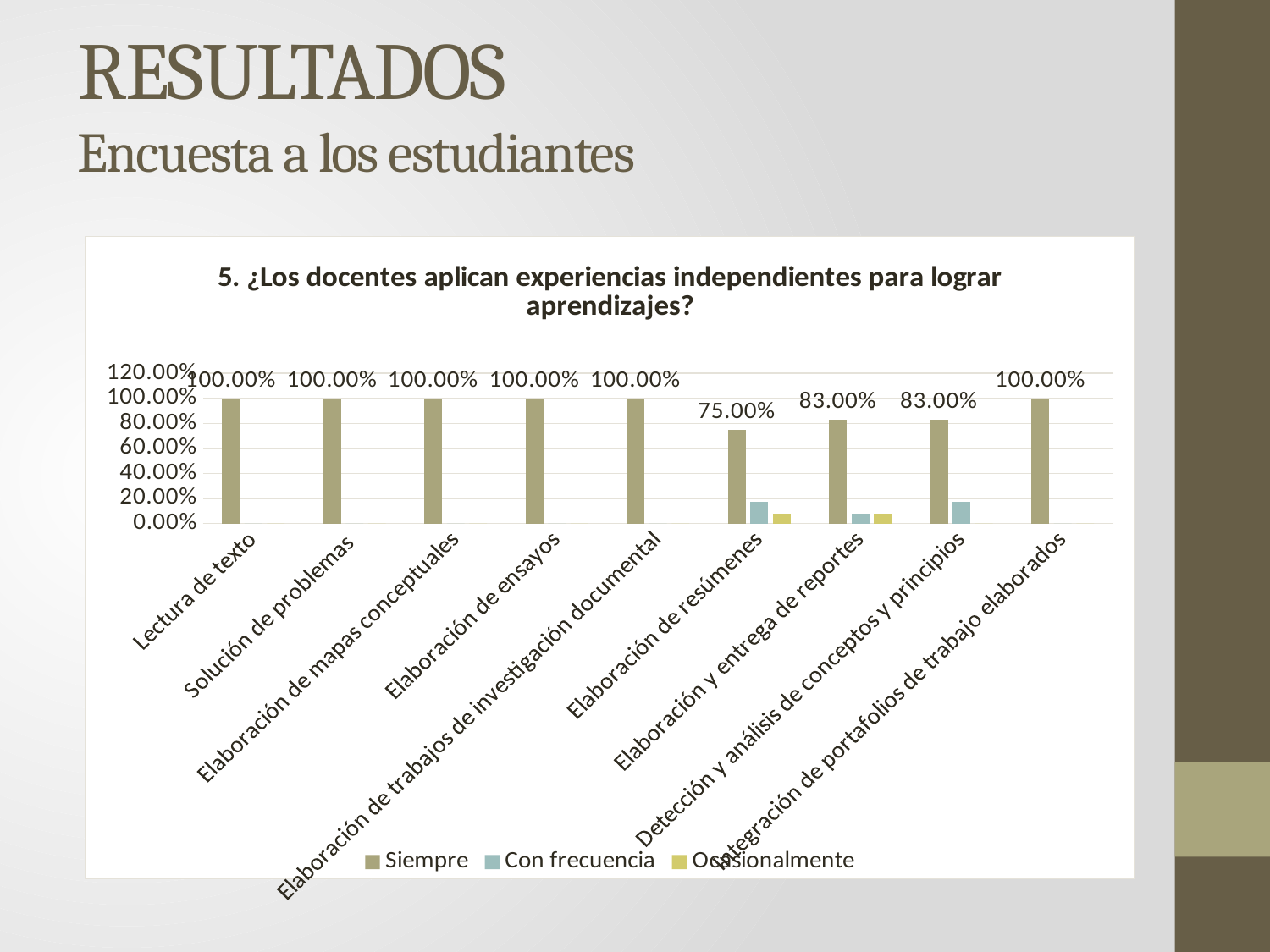
How many series does the chart legend list? 3 What is the value of the "Siempre" series for "Integración de portafolios de trabajo elaborados"? 100.00% What is the value of the "Siempre" series for "Elaboración y entrega de reportes"? 83.00% How many categories are shown on the x axis of the chart? 9 Which is larger for the "Siempre" series: "Elaboración de ensayos" or "Detección y análisis de conceptos y principios"? Elaboración de ensayos What is the value of the "Siempre" series for "Lectura de texto"? 100.00% What is the difference between the "Siempre" value for "Lectura de texto" and the "Siempre" value for "Elaboración de resúmenes"? 25.00% Which category has the lowest value for the "Siempre" series? Elaboración de resúmenes Is the "Con frecuencia" value for "Elaboración de resúmenes" greater or less than 20.00%? less What kind of chart is shown on the slide? Bar chart What is the value of the "Siempre" series for "Elaboración de resúmenes"? 75.00% What are the three series listed in the chart legend? Siempre, Con frecuencia, Ocasionalmente